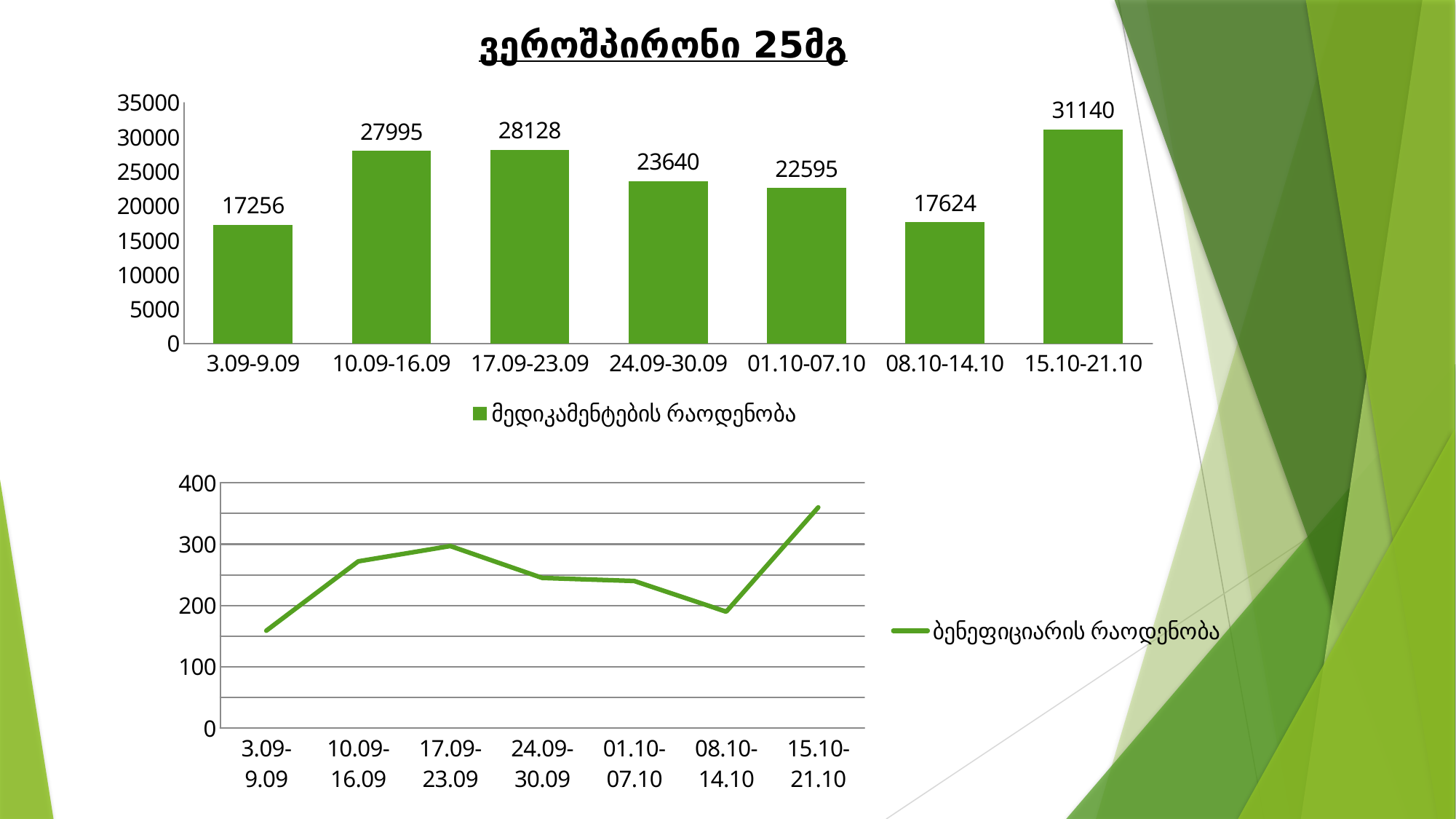
What kind of chart is the bottom chart on the slide? line chart How many periods are shown in the top bar chart? 7 In the top bar chart, which period has the highest value? 15.10-21.10 In the top bar chart, which period has the lowest value? 3.09-9.09 What is the title of the top bar chart? ვეროშპირონი 25მგ In the top bar chart, what is the difference between the values for 15.10-21.10 and 3.09-9.09? 13884 In the top bar chart, what is the value for 10.09-16.09? 27995 In the top bar chart, what is the value for 08.10-14.10? 17624 In the top bar chart, which is larger: the value for 24.09-30.09 or the value for 01.10-07.10? 24.09-30.09 In the bottom line chart, is the value for 15.10-21.10 greater or less than 300? greater What kind of chart is the top chart on the slide? bar chart In the bottom line chart, is the value for 3.09-9.09 greater or less than 200? less